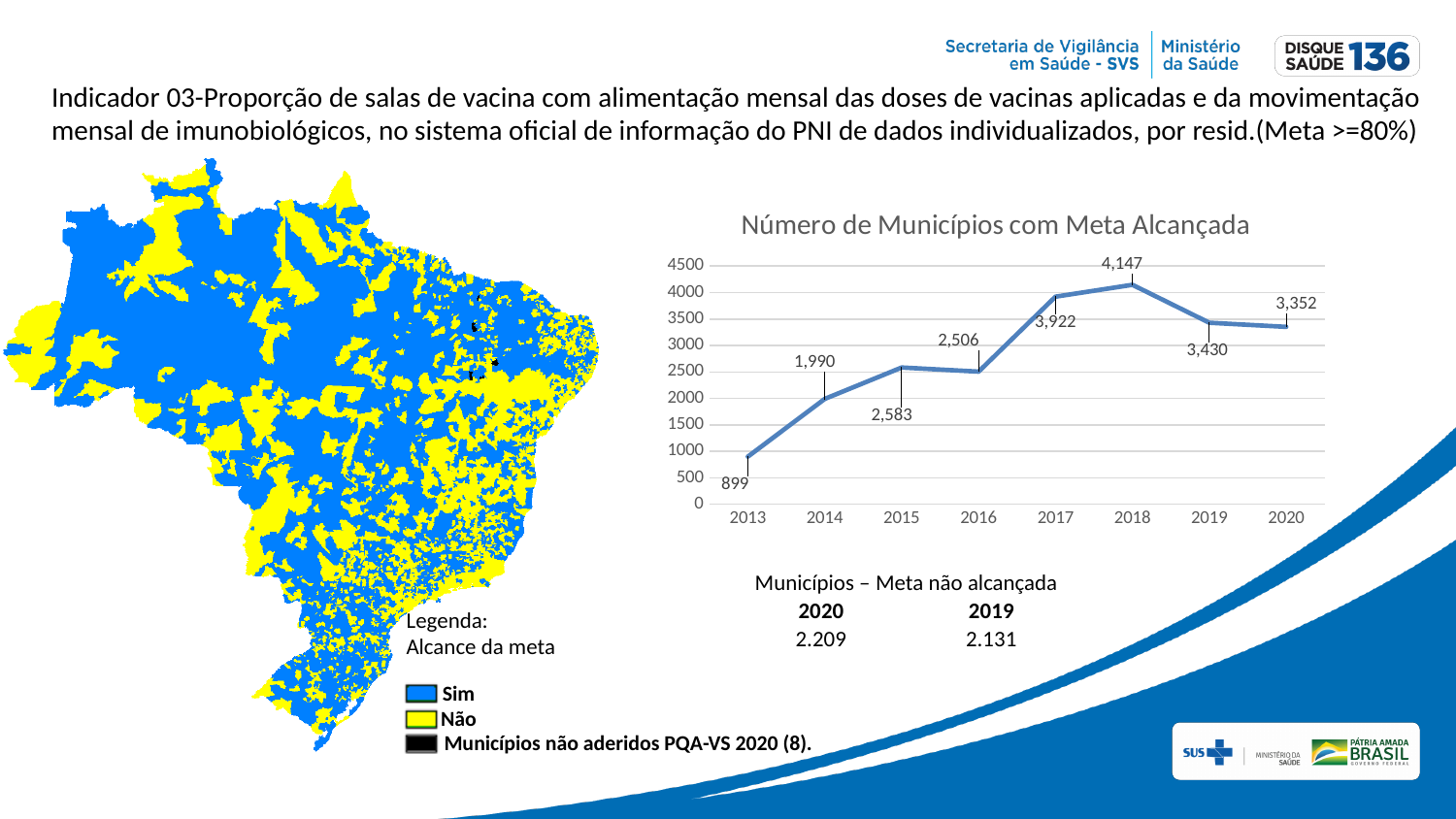
In the chart 'Número de Municípios com Meta Alcançada', is the value for 2017 greater or less than 3500? greater In the chart 'Número de Municípios com Meta Alcançada', what is the difference between the values for 2018 and 2019? 717 In the chart 'Número de Municípios com Meta Alcançada', what is the value for 2018? 4,147 In the chart 'Número de Municípios com Meta Alcançada', does the value rise or fall from 2013 to 2014? rise How many years are plotted in the chart 'Número de Municípios com Meta Alcançada'? 8 In the chart 'Número de Municípios com Meta Alcançada', which year has the highest value? 2018 What type of chart is 'Número de Municípios com Meta Alcançada'? line chart In the chart 'Número de Municípios com Meta Alcançada', which year has the lowest value? 2013 In the chart 'Número de Municípios com Meta Alcançada', which year has the larger value, 2015 or 2016? 2015 In the chart 'Número de Municípios com Meta Alcançada', what is the value for 2013? 899 In the chart 'Número de Municípios com Meta Alcançada', what is the value for 2020? 3,352 In the chart 'Número de Municípios com Meta Alcançada', what is the value for 2016? 2,506